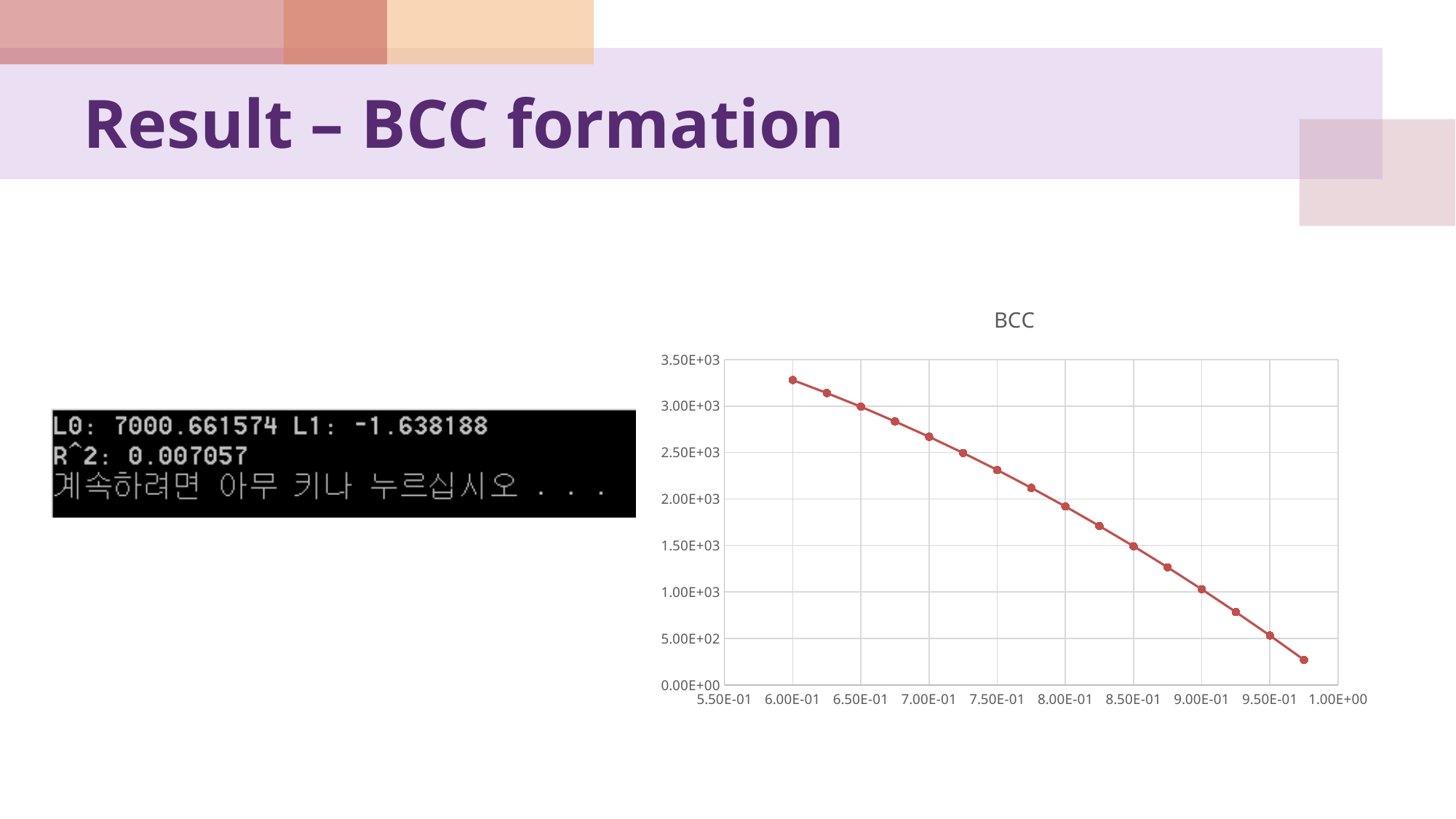
Is the value at x = 7.50E-01 greater or less than 2.50E+03? less Is the value at x = 6.00E-01 greater or less than 3.00E+03? greater Is the value at x = 7.00E-01 greater or less than 2.50E+03? greater Do the values on the BCC chart rise or fall as x increases? fall How many data points are plotted on the BCC chart? 16 What is the title of the chart? BCC Which is larger on the BCC chart: the value at x = 6.50E-01 or the value at x = 8.50E-01? 6.50E-01 At which x value does the BCC chart reach its highest y value? 6.00E-01 What kind of chart is shown on the slide? line chart